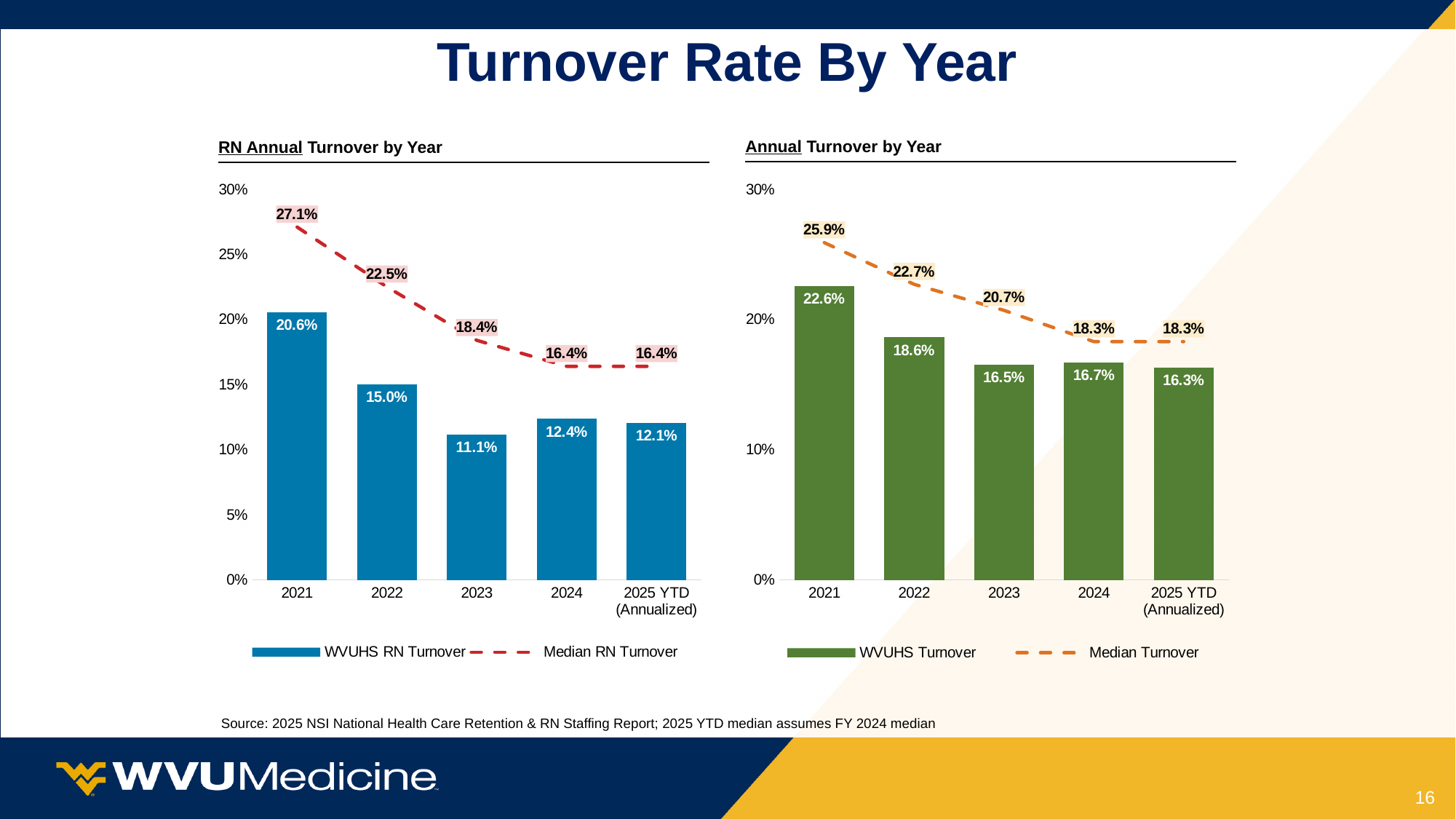
In the 'RN Annual Turnover by Year' chart, what is the WVUHS RN Turnover value for 2021? 20.6% In the 'RN Annual Turnover by Year' chart, which year has the lowest WVUHS RN Turnover? 2023 In the 'Annual Turnover by Year' chart, which is larger in 2024: WVUHS Turnover or Median Turnover? Median Turnover In the 'RN Annual Turnover by Year' chart, what is the Median RN Turnover value for 2023? 18.4% In the 'Annual Turnover by Year' chart, how many series does the legend list? 2 What colour are the bars in the 'Annual Turnover by Year' chart? green In the 'Annual Turnover by Year' chart, what is the WVUHS Turnover value for 2025 YTD (Annualized)? 16.3% In the 'RN Annual Turnover by Year' chart, what is the difference between the Median RN Turnover and the WVUHS RN Turnover in 2022? 7.5% In the 'Annual Turnover by Year' chart, which year has the highest WVUHS Turnover? 2021 In the 'Annual Turnover by Year' chart, what is the Median Turnover value for 2021? 25.9% In the 'RN Annual Turnover by Year' chart, how many years are shown on the x axis? 5 In the 'RN Annual Turnover by Year' chart, does the Median RN Turnover rise or fall from 2021 to 2024? fall